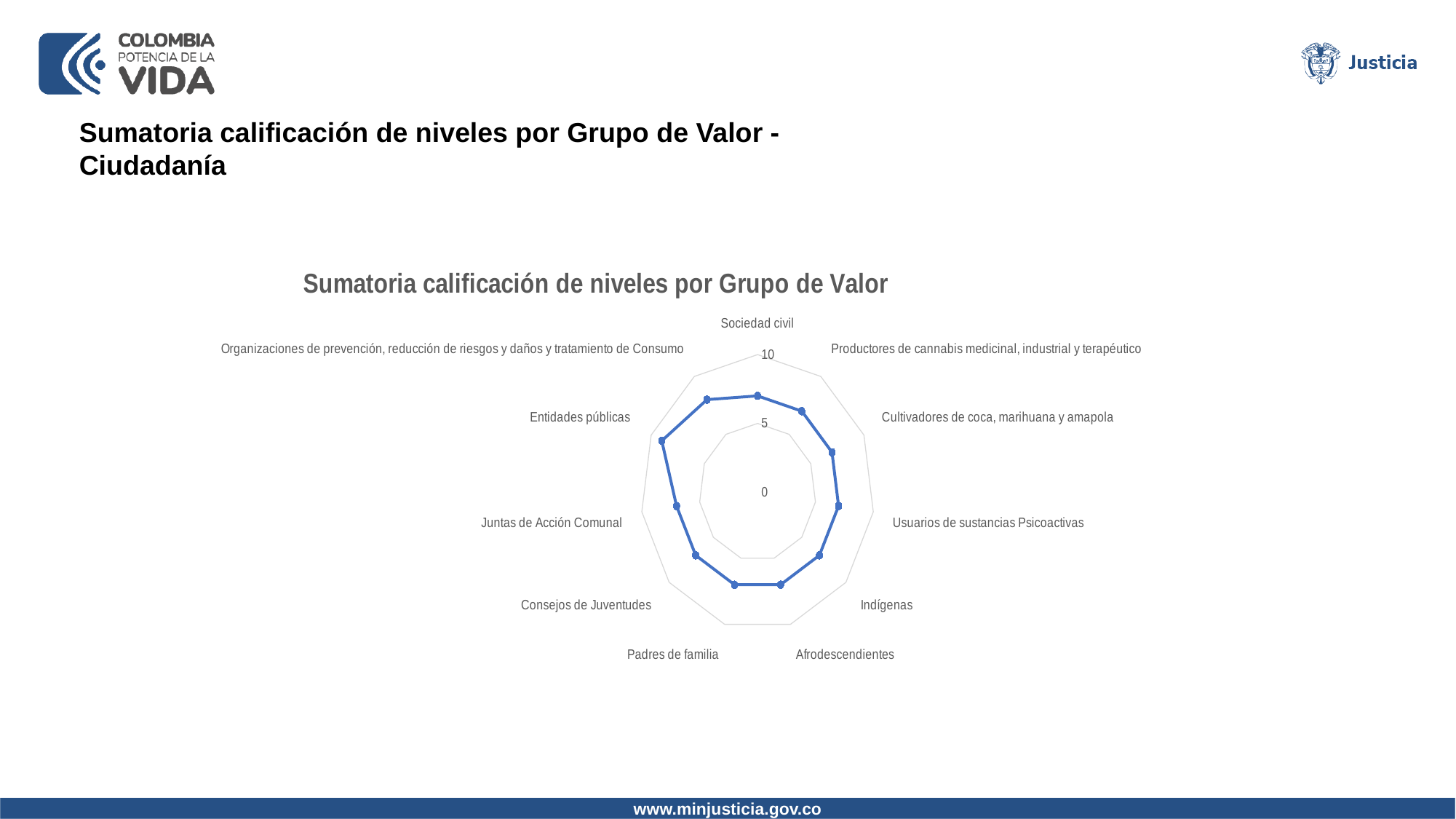
Is the value for Indígenas greater or less than 5? greater Is the value for Entidades públicas greater or less than 10? less Is the value for Sociedad civil greater or less than 5? greater How many categories (groups) are plotted on the radar chart? 11 What is the maximum value shown on the radar chart's axis scale? 10 What kind of chart is shown on the slide? radar chart What is the title of the chart? Sumatoria calificación de niveles por Grupo de Valor